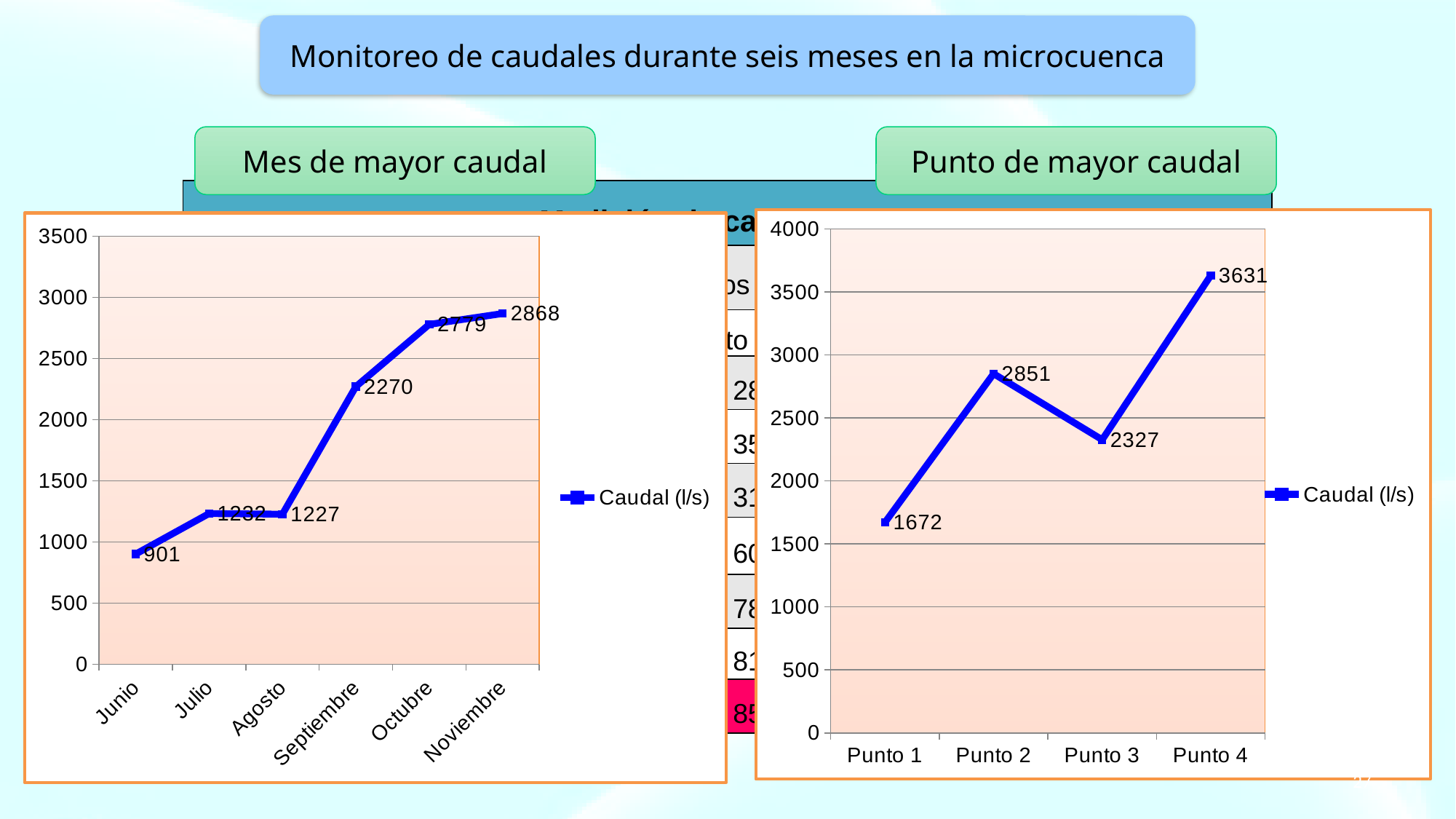
In the left chart (Mes de mayor caudal), what is the difference between the values for Noviembre and Octubre? 89 In the left chart (Mes de mayor caudal), what is the value for Junio? 901 In the left chart (Mes de mayor caudal), which month has the lowest value? Junio In the right chart (Punto de mayor caudal), which is larger, the value for Punto 2 or Punto 3? Punto 2 In the right chart (Punto de mayor caudal), what is the difference between the values for Punto 4 and Punto 1? 1959 In the left chart (Mes de mayor caudal), how many months are plotted? 6 In the right chart (Punto de mayor caudal), what is the value for Punto 3? 2327 In the right chart (Punto de mayor caudal), what series name does the legend show? Caudal (l/s) In the left chart (Mes de mayor caudal), what kind of chart is shown? Line chart In the right chart (Punto de mayor caudal), which point has the highest value? Punto 4 In the left chart (Mes de mayor caudal), what is the value for Septiembre? 2270 In the left chart (Mes de mayor caudal), which month has the highest value? Noviembre